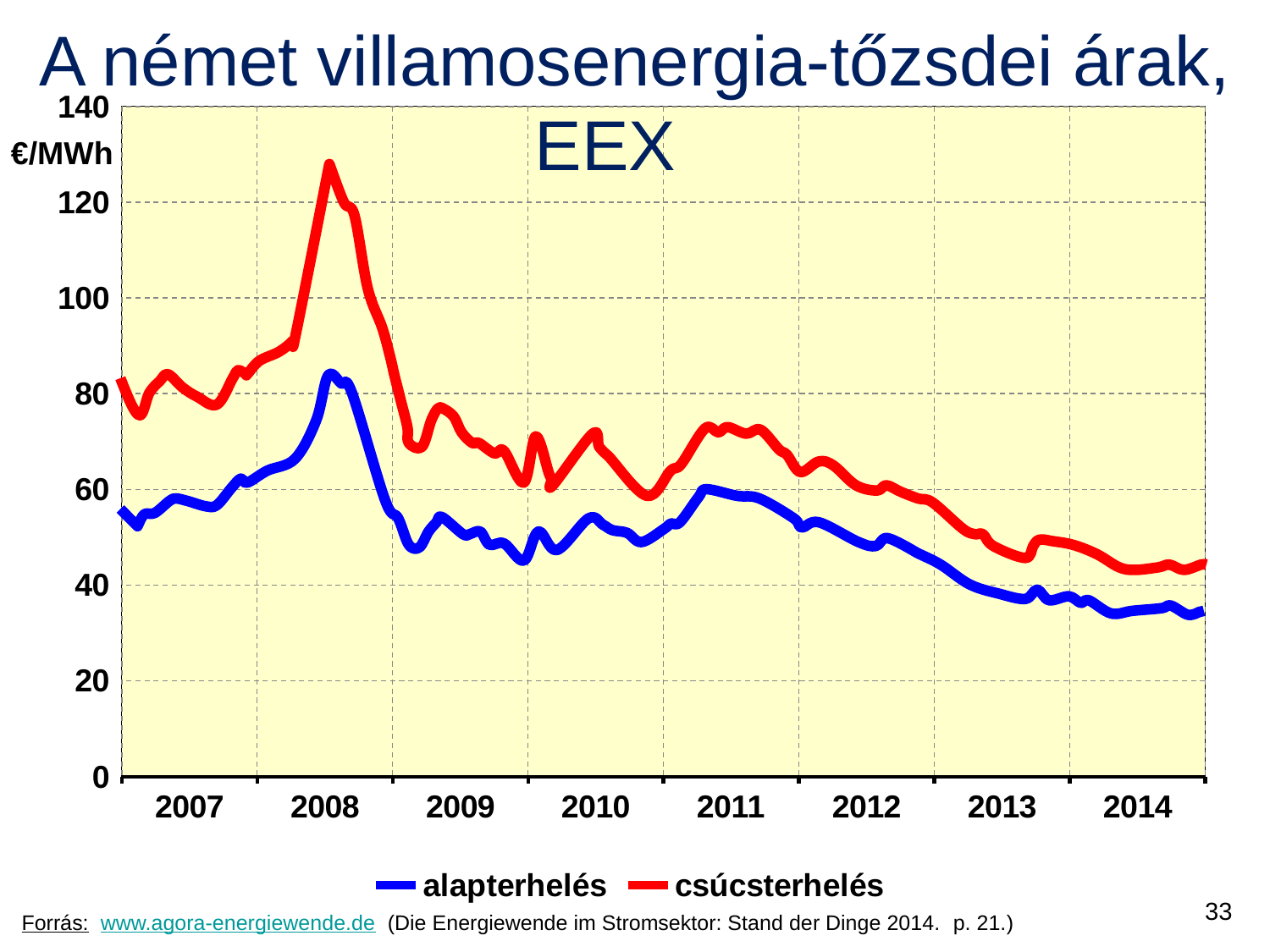
What unit is shown on the vertical axis? €/MWh Which series has the higher values throughout the period, alapterhelés or csúcsterhelés? csúcsterhelés How many series does the legend list? 2 What are the two series named in the legend? alapterhelés and csúcsterhelés Is the peak value of alapterhelés in 2008 greater or less than 100? less In which year does alapterhelés reach its lowest values? 2014 Is the peak value of csúcsterhelés in 2008 greater or less than 120? greater Is the value of csúcsterhelés at the start of 2007 greater or less than 60? greater What kind of chart is shown on the slide? line chart In which year does csúcsterhelés reach its highest value? 2008 Do the alapterhelés values rise or fall from 2011 to 2014? fall